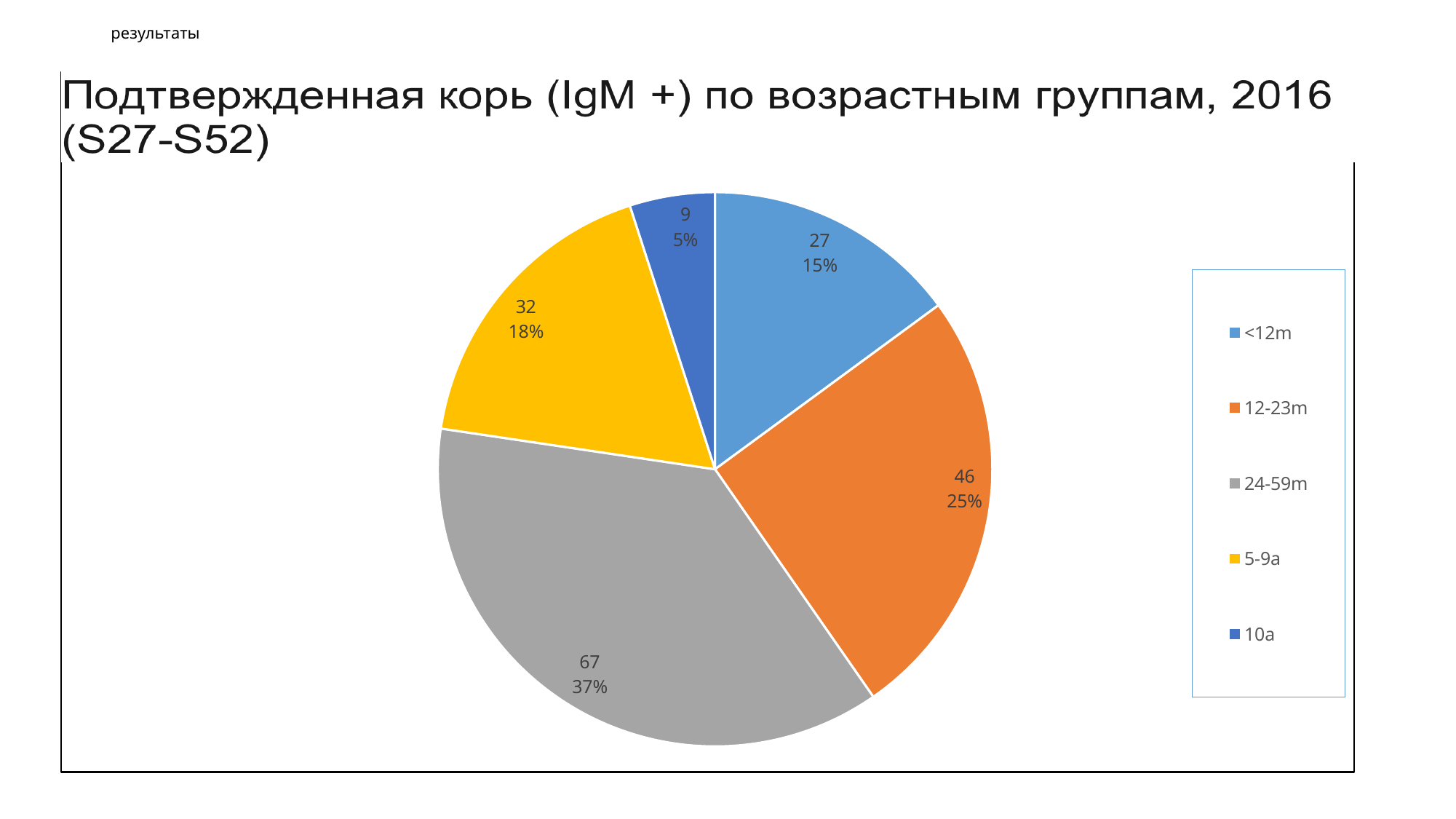
What is the number of confirmed measles cases for the 24-59m age group? 67 Which is larger, the value for 5-9a or the value for <12m? 5-9a Which age group has the largest slice of the pie? 24-59m Which age group has the smallest slice of the pie? 10a What colour is the slice for the 24-59m age group? grey What kind of chart is shown on the slide? pie chart How many age groups does the legend list? 5 What is the difference between the values for 24-59m and 12-23m? 21 What is the value for the 5-9a age group? 32 What percentage share does the 10a age group have? 5% What is the value for the <12m age group? 27 What percentage share does the 12-23m age group have? 25%